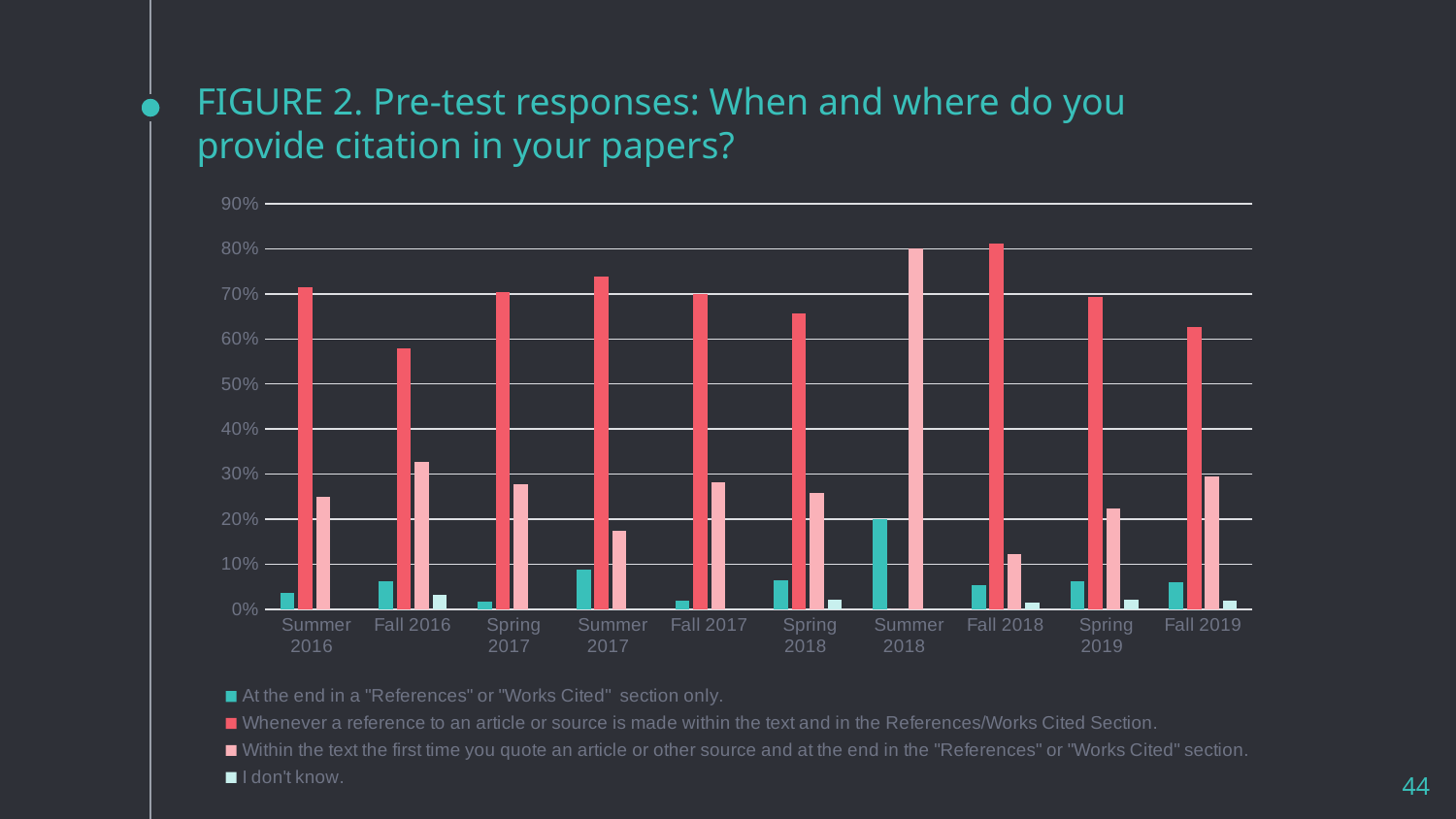
Which semester has the highest value for the series "Within the text the first time you quote an article or other source and at the end in the "References" or "Works Cited" section"? Summer 2018 Which series is shown in teal in the legend? At the end in a "References" or "Works Cited" section only. Which semester has the highest value for the series "At the end in a "References" or "Works Cited" section only"? Summer 2018 What kind of chart is shown on the slide? bar chart Which semester has the highest value for the series "Whenever a reference to an article or source is made within the text and in the References/Works Cited Section"? Fall 2018 How many semester categories are shown along the x axis? 10 Is the value for "At the end in a "References" or "Works Cited" section only" in Summer 2018 greater or less than 10%? greater Is the value for "Whenever a reference to an article or source is made within the text and in the References/Works Cited Section" in Summer 2017 greater or less than 70%? greater Is the value for "Within the text the first time you quote an article or other source and at the end in the "References" or "Works Cited" section" in Fall 2016 greater or less than 30%? greater How many series does the legend list? 4 For the series "Whenever a reference to an article or source is made within the text and in the References/Works Cited Section", which is larger: Fall 2016 or Spring 2017? Spring 2017